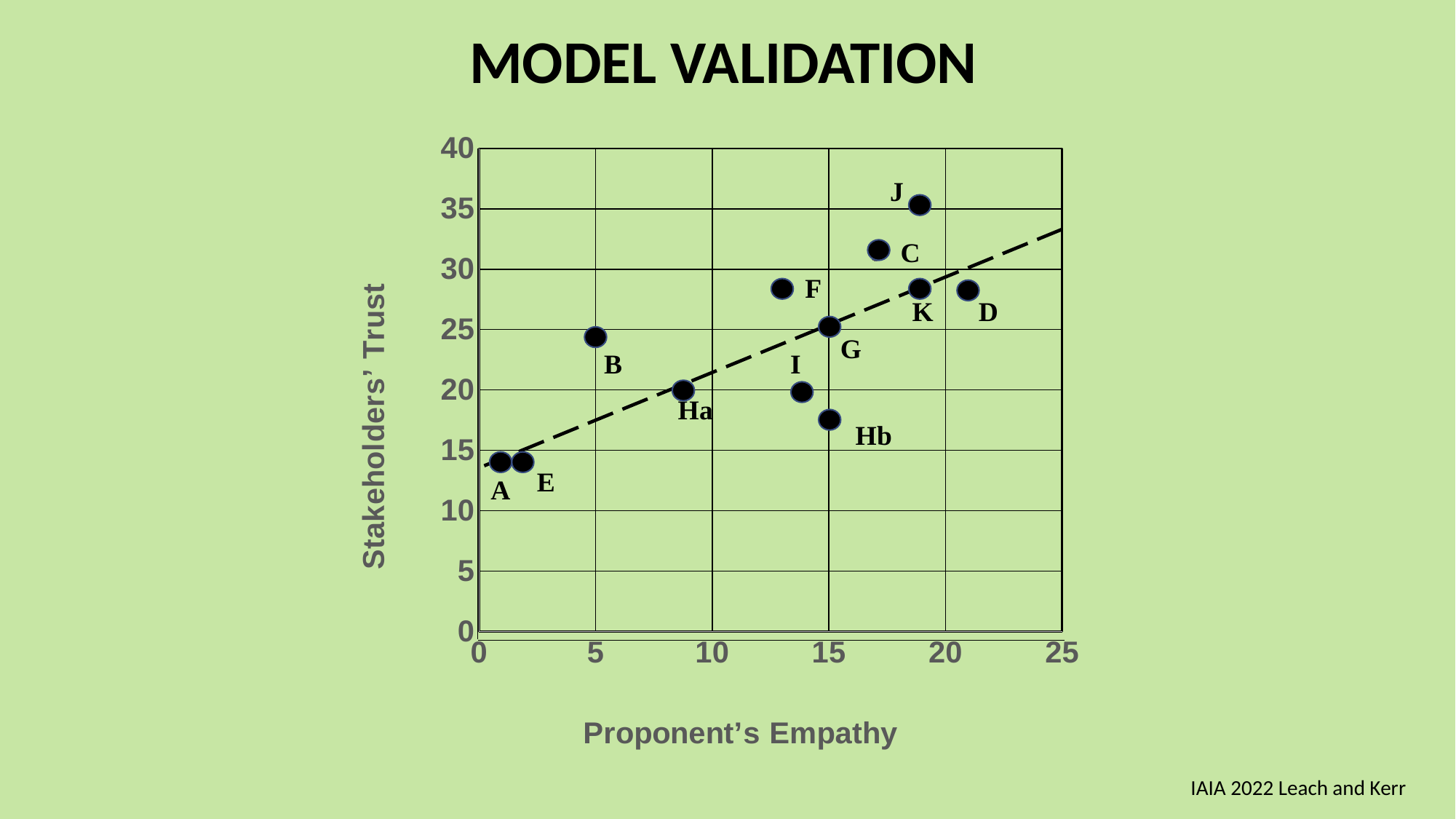
Which point has a higher Stakeholders' Trust value, F or I? F What is the label of the vertical axis? Stakeholders' Trust Which point has a higher Stakeholders' Trust value, J or C? J Is the Stakeholders' Trust value for point C greater or less than 30? greater Which data point has the highest Proponent's Empathy value? D Which data point has the highest Stakeholders' Trust value? J Is the Stakeholders' Trust value for point Hb greater or less than 20? less Does the dashed trend line rise or fall as Proponent's Empathy increases? Rises How many labelled data points are plotted on the chart? 12 Is the Stakeholders' Trust value for point B greater or less than 20? greater What kind of chart is shown on the slide? Scatter chart